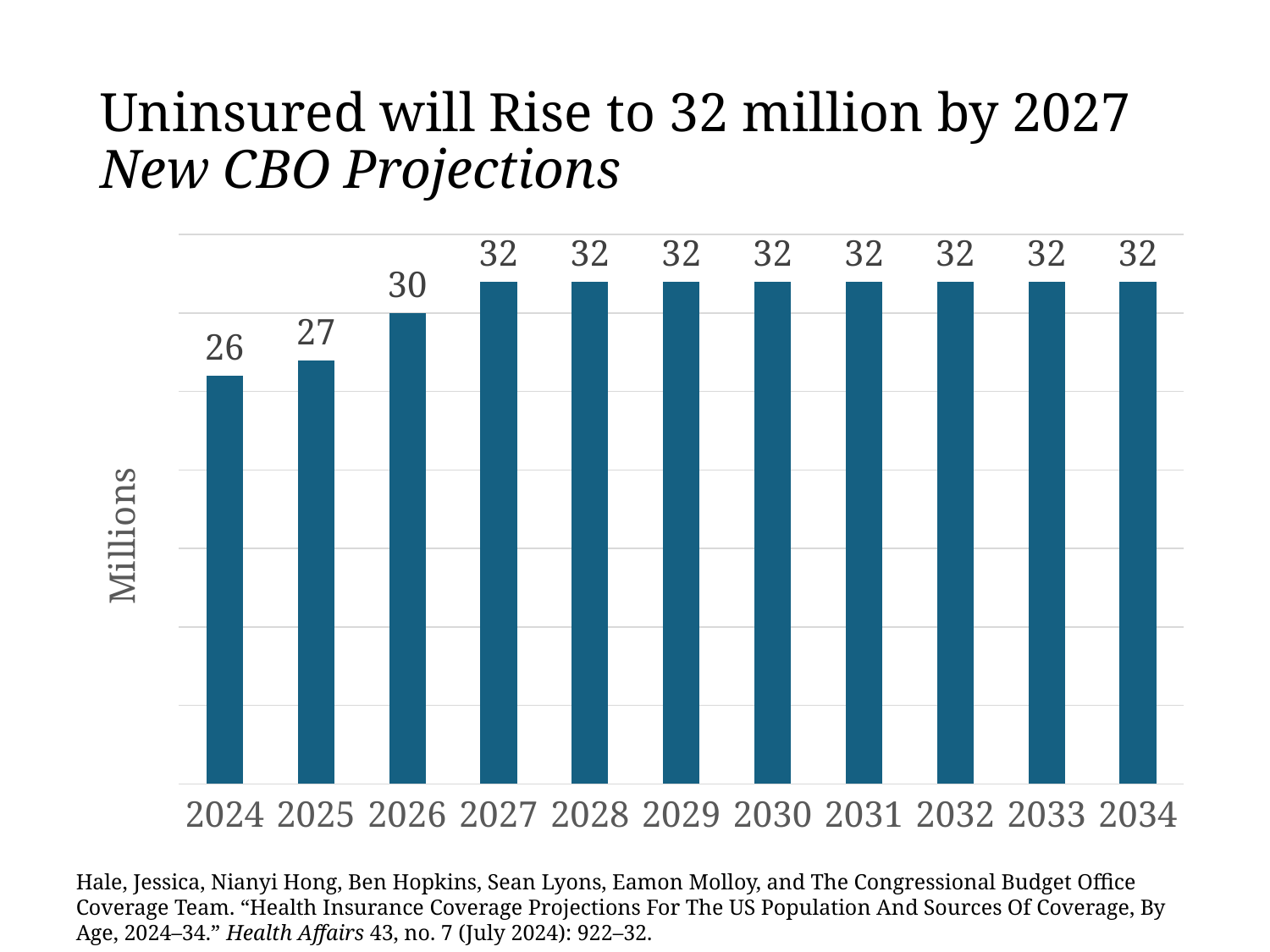
What is the label on the y axis? Millions Which is larger, the value for 2025 or the value for 2026? 2026 In which year does the value first reach 32? 2027 What is the value for 2024? 26 What kind of chart is this? bar chart How many years are shown on the x axis? 11 Which year has the lowest value? 2024 What is the difference between the values for 2027 and 2024? 6 Do the values rise or fall from 2024 to 2027? rise What is the value for 2026? 30 What is the value for 2030? 32 What is the difference between the values for 2026 and 2025? 3